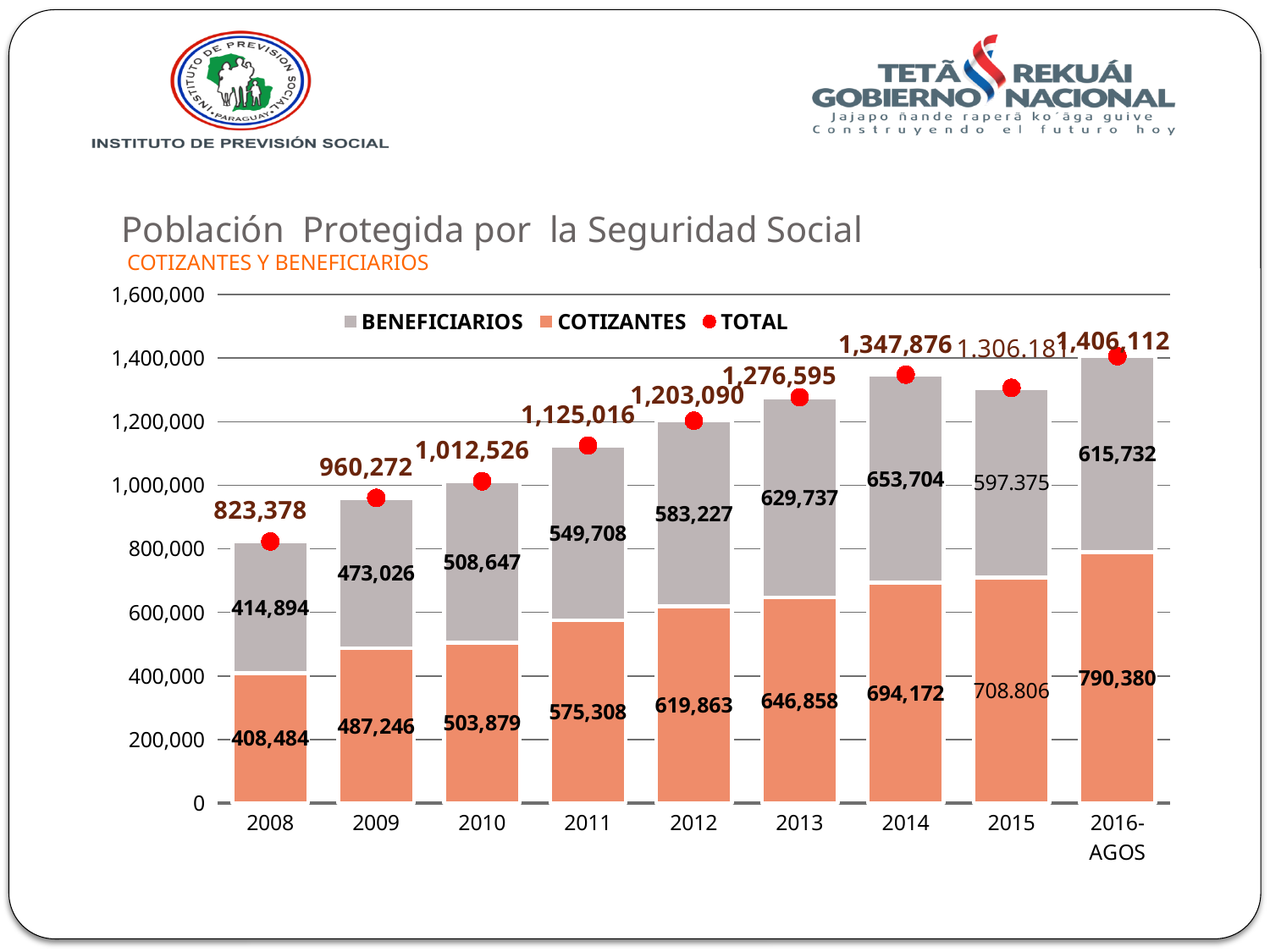
How many series does the legend list? 3 In 2011, which is larger: COTIZANTES or BENEFICIARIOS? COTIZANTES Which year has the lowest BENEFICIARIOS value? 2008 Do the COTIZANTES values rise or fall from 2008 to 2016-AGOS? rise What is the TOTAL value shown for 2014? 1,347,876 What is the BENEFICIARIOS value for 2010? 508,647 How many years (categories) are shown on the x axis? 9 What is the difference between the COTIZANTES value for 2016-AGOS and for 2008? 381,896 Which year has the highest COTIZANTES value? 2016-AGOS Is the TOTAL value for 2008 greater or less than 1,000,000? less What is the COTIZANTES value for 2012? 619,863 Which year has the highest BENEFICIARIOS value? 2014